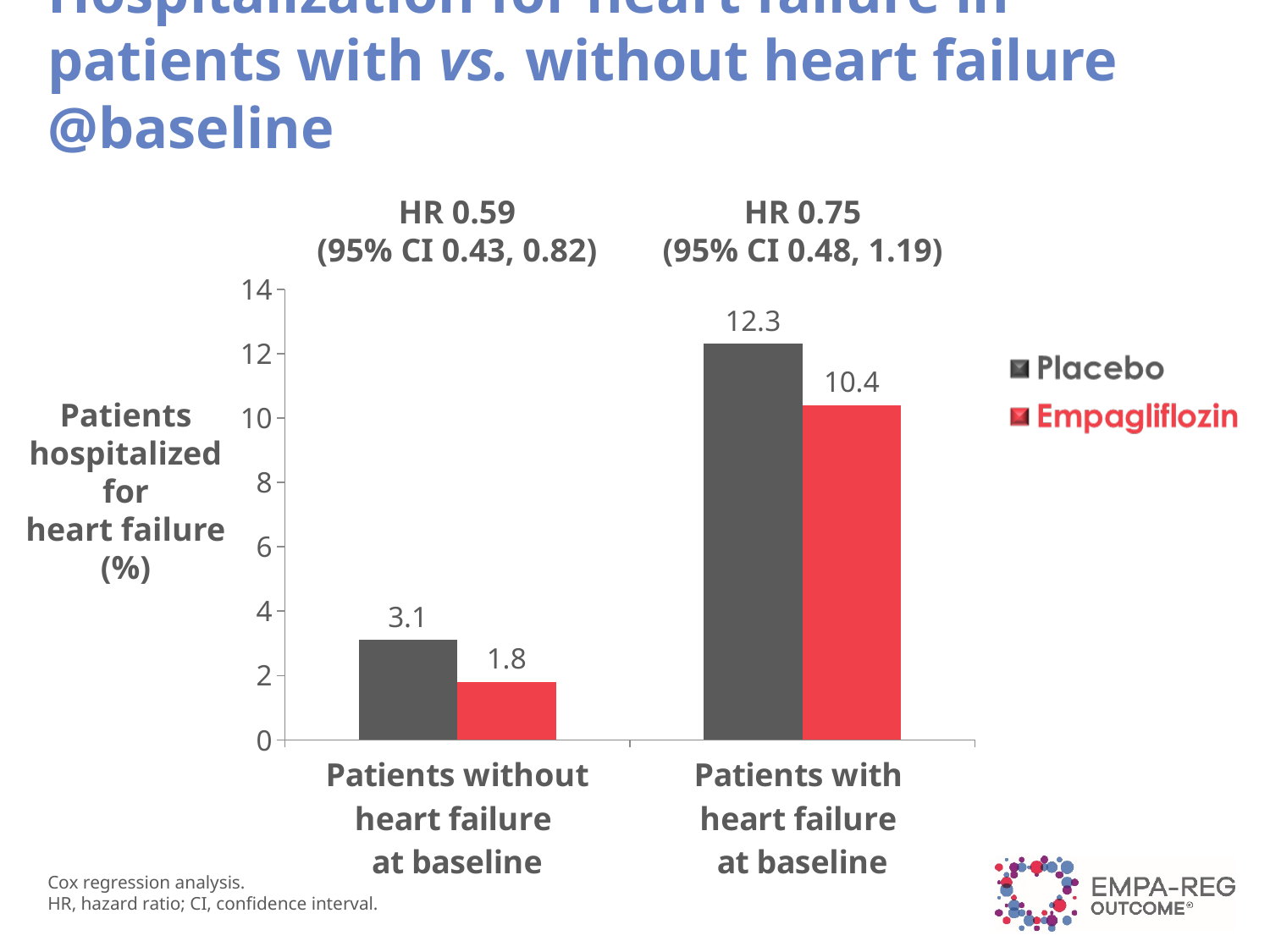
Is the empagliflozin value for patients with heart failure at baseline greater or less than 8? greater What is the difference between placebo and empagliflozin in patients without heart failure at baseline? 1.3 Which bar shows the lowest percentage of patients hospitalized for heart failure? Empagliflozin, patients without heart failure at baseline What percentage of empagliflozin patients with heart failure at baseline were hospitalized for heart failure? 10.4 Which is larger: the placebo value for patients with heart failure at baseline or the placebo value for patients without heart failure at baseline? Patients with heart failure at baseline What percentage of placebo patients without heart failure at baseline were hospitalized for heart failure? 3.1 What is the difference between placebo and empagliflozin in patients with heart failure at baseline? 1.9 What is the value for empagliflozin in patients without heart failure at baseline? 1.8 What kind of chart is shown on the slide? Bar chart How many series does the legend list? 2 What hazard ratio is shown above the bars for patients with heart failure at baseline? HR 0.75 Which bar shows the highest percentage of patients hospitalized for heart failure? Placebo, patients with heart failure at baseline